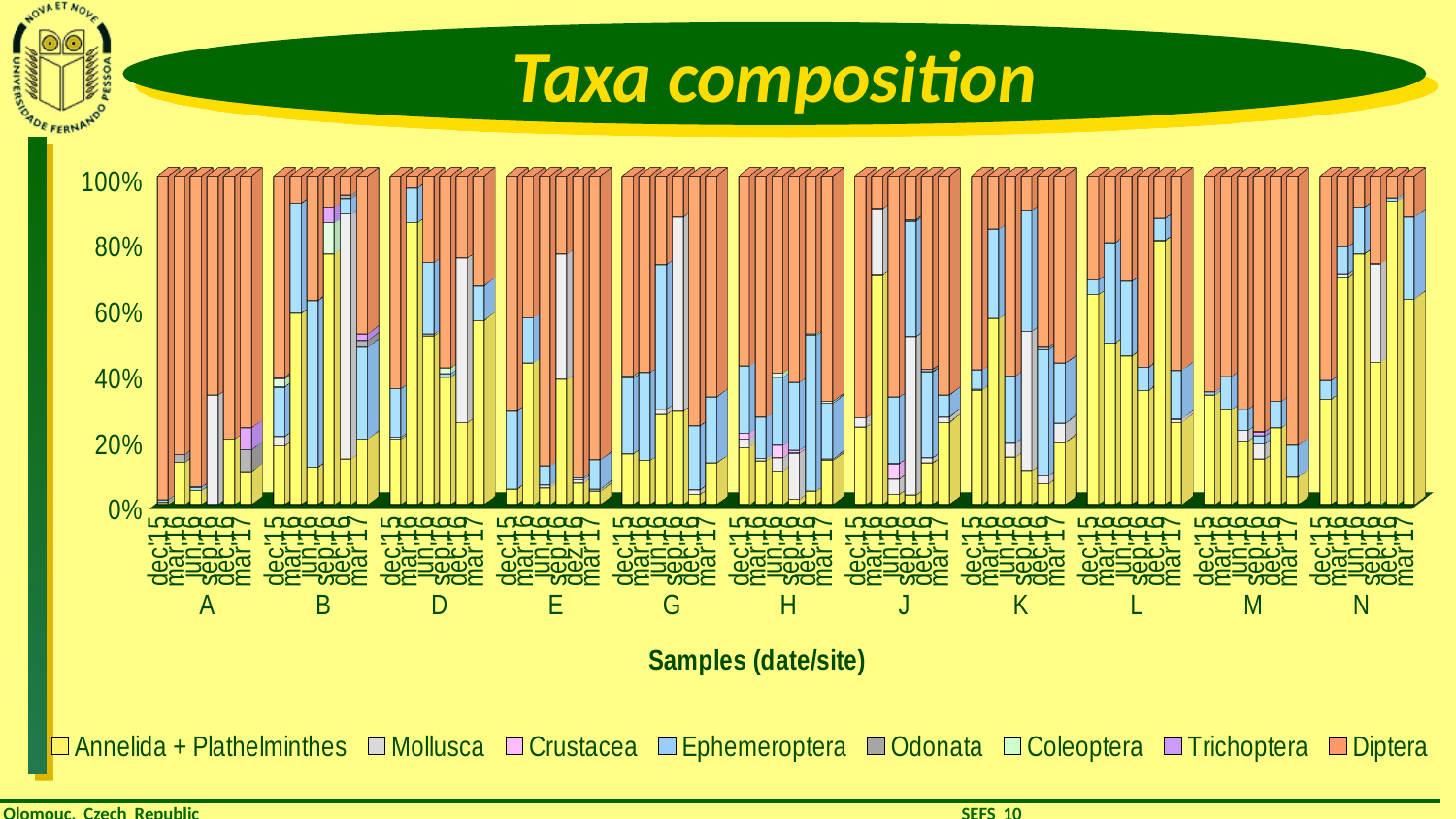
How many sites are labelled along the x axis? 11 Which site label comes immediately after B on the x axis? D Is the Annelida + Plathelminthes share in the last bar (mar'17) of site N greater or less than 40%? greater Which series is listed last in the legend? Diptera What is the title of the chart? Taxa composition How many series does the legend list? 8 What kind of chart is shown on the slide? Stacked bar chart How many sample bars are plotted for each site? 6 Is the Diptera share in the first bar (dec'15) of site A greater or less than 80%? greater